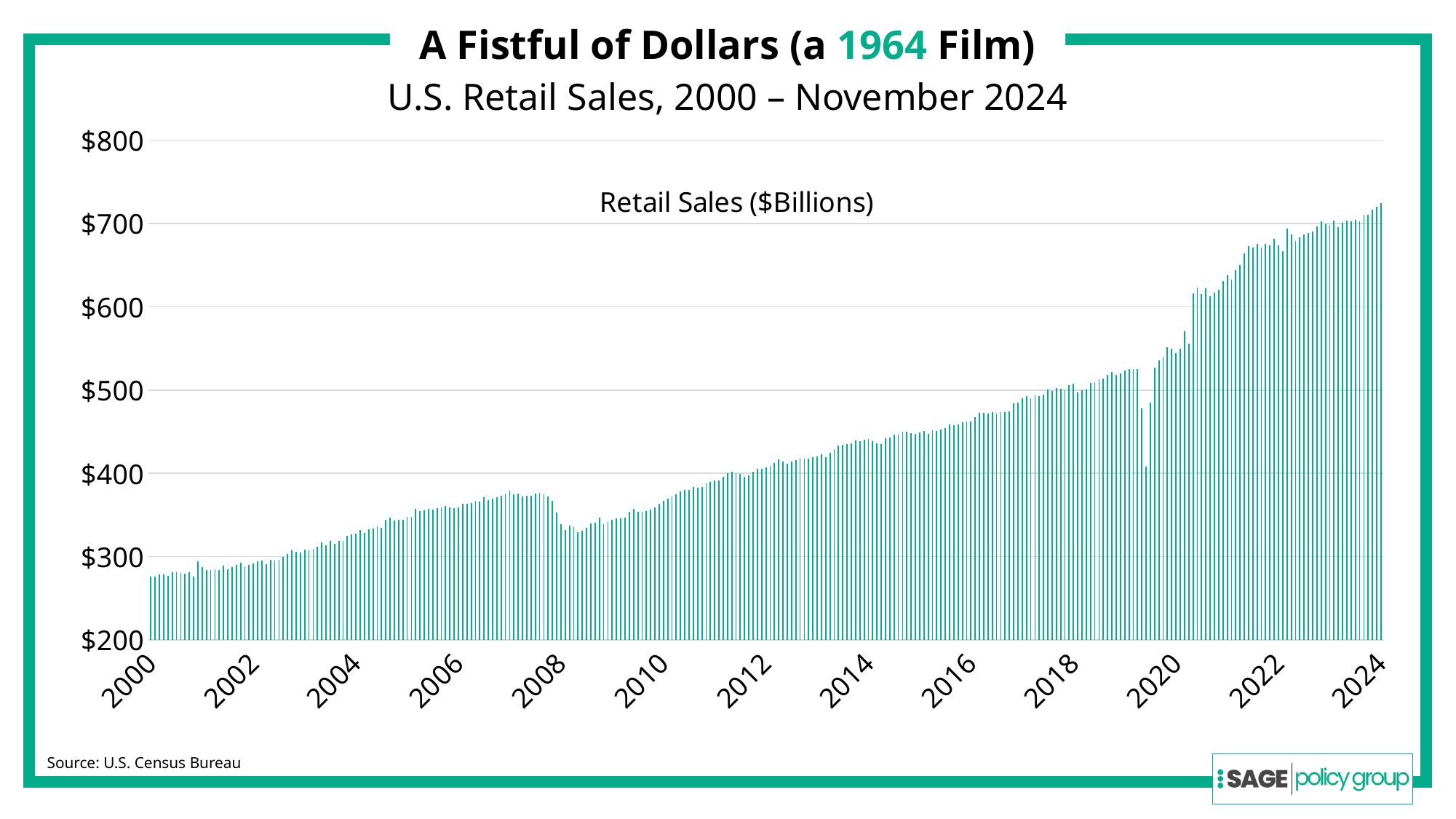
Is the value for retail sales at the end of the series (November 2024) greater or less than $700? greater What is the label of the plotted series? Retail Sales ($Billions) What is the title of the chart? Retail Sales ($Billions) Which is larger, retail sales at the start of 2008 or at the start of 2009? 2008 Is the value for retail sales at the start of 2004 greater or less than $300? greater Is the lowest value for retail sales during 2020 greater or less than $500? less What kind of chart is shown on the slide? Bar chart Do retail sales generally rise or fall from 2000 to 2024? Rise Which is larger, retail sales in 2000 or in 2024? 2024